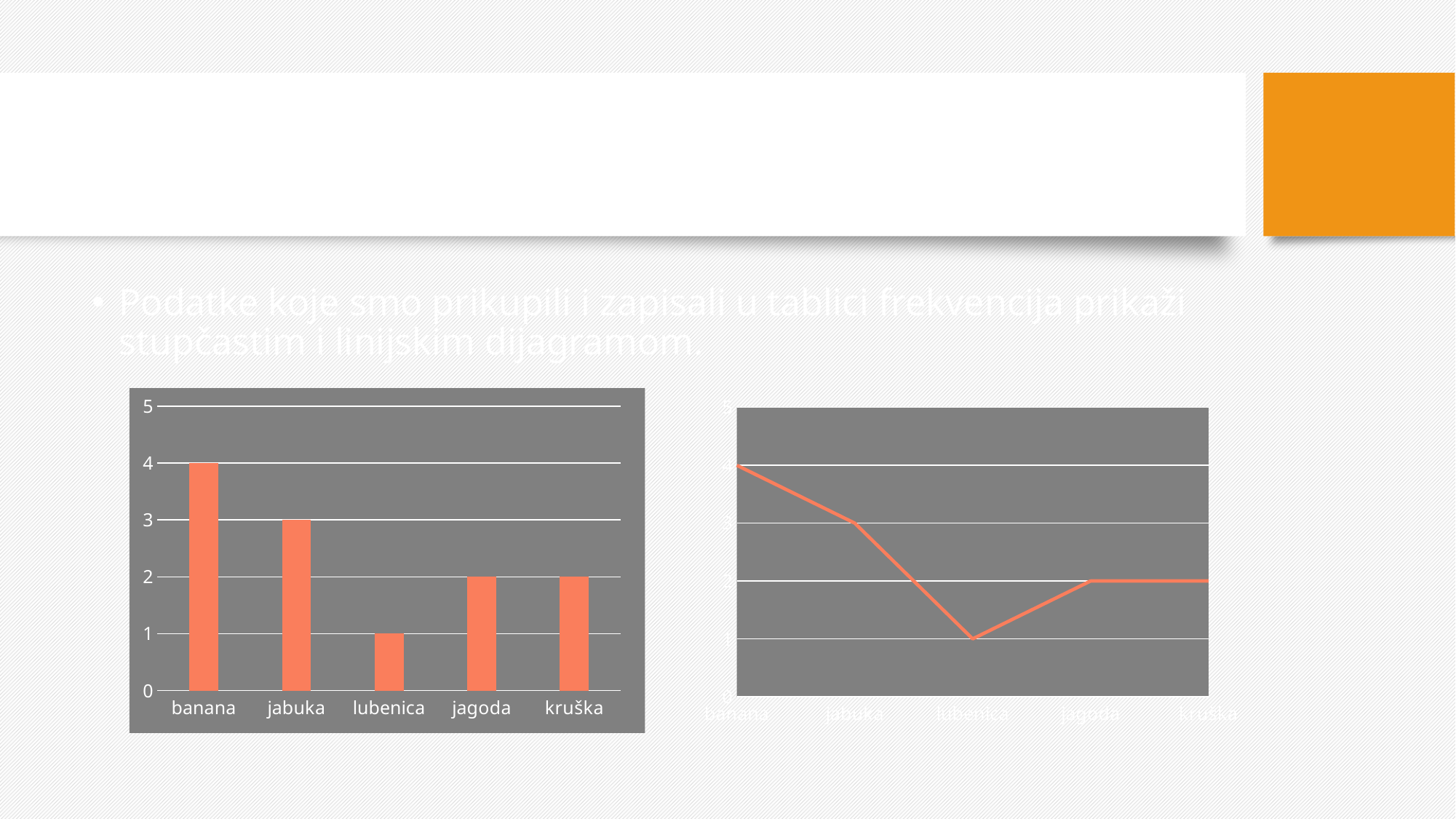
How many categories are shown on the left bar chart? 5 On the left bar chart, what is the value for banana? 4 On the left bar chart, which category has the lowest value? lubenica On the left bar chart, which is larger, the value for jabuka or the value for kruška? jabuka On the left bar chart, which category has the highest value? banana On the left bar chart, what is the value for lubenica? 1 On the right line chart, does the line rise or fall from banana to lubenica? fall On the left bar chart, what is the difference between the values for banana and lubenica? 3 What kind of chart is the chart on the left of the slide? bar chart On the left bar chart, what is the value for jabuka? 3 On the left bar chart, what is the value for jagoda? 2 What kind of chart is the chart on the right of the slide? line chart